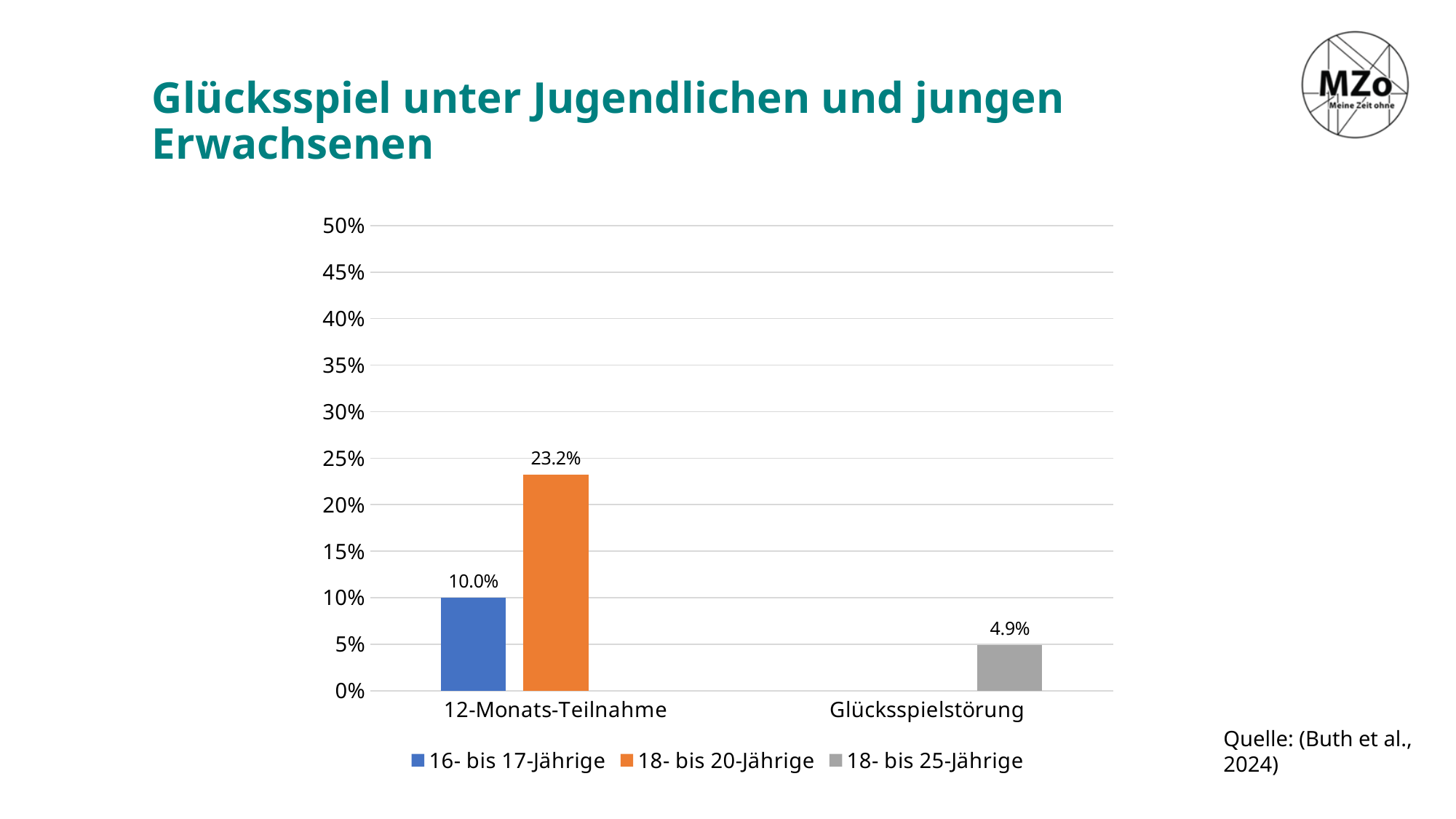
What colour is the bar for 18- bis 20-Jährige? orange What kind of chart is shown on the slide? bar chart Is the value for 18- bis 20-Jährige in 12-Monats-Teilnahme greater or less than 20%? greater What is the value for 18- bis 25-Jährige in the Glücksspielstörung category? 4.9% Which series has the highest value in the 12-Monats-Teilnahme category? 18- bis 20-Jährige Which bar on the chart has the lowest value? 18- bis 25-Jährige (Glücksspielstörung) What is the difference between the 18- bis 20-Jährige and 16- bis 17-Jährige values for 12-Monats-Teilnahme? 13.2% What is the value for 18- bis 20-Jährige in the 12-Monats-Teilnahme category? 23.2% How many series does the legend list? 3 What is the value for 16- bis 17-Jährige in the 12-Monats-Teilnahme category? 10.0% Which is larger: the 16- bis 17-Jährige value for 12-Monats-Teilnahme or the 18- bis 25-Jährige value for Glücksspielstörung? 16- bis 17-Jährige value for 12-Monats-Teilnahme How many categories are shown on the x axis? 2